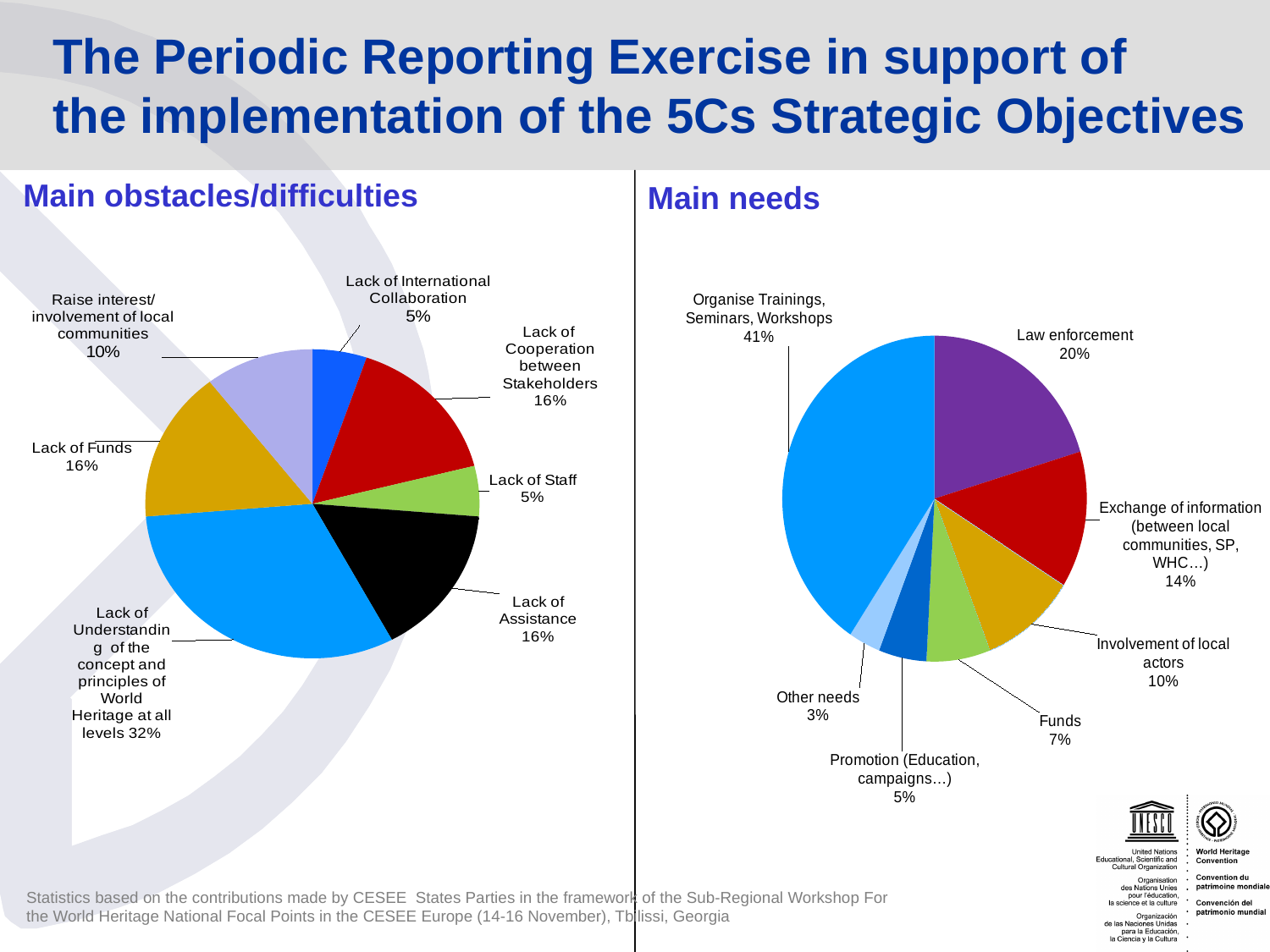
In the 'Main obstacles/difficulties' chart, what is the difference between the shares for Lack of Understanding and Lack of Assistance? 16% In the 'Main needs' chart, what share is labelled for Organise Trainings, Seminars, Workshops? 41% In the 'Main needs' chart, what share is labelled for Promotion (Education, campaigns…)? 5% What kind of chart is used for 'Main needs'? Pie chart In the 'Main needs' chart, which category has the smallest slice? Other needs In the 'Main needs' chart, what share is shown for Law enforcement? 20% In the 'Main obstacles/difficulties' chart, how many slices does the pie have? 7 In the 'Main obstacles/difficulties' chart, which category has the largest slice? Lack of Understanding of the concept and principles of World Heritage at all levels In the 'Main needs' chart, which is larger: Exchange of information or Involvement of local actors? Exchange of information In the 'Main obstacles/difficulties' chart, what share is labelled for Lack of Funds? 16% In the 'Main obstacles/difficulties' chart, what share is shown for Raise interest/involvement of local communities? 10% In the 'Main needs' chart, what is the difference between the shares for Law enforcement and Funds? 13%